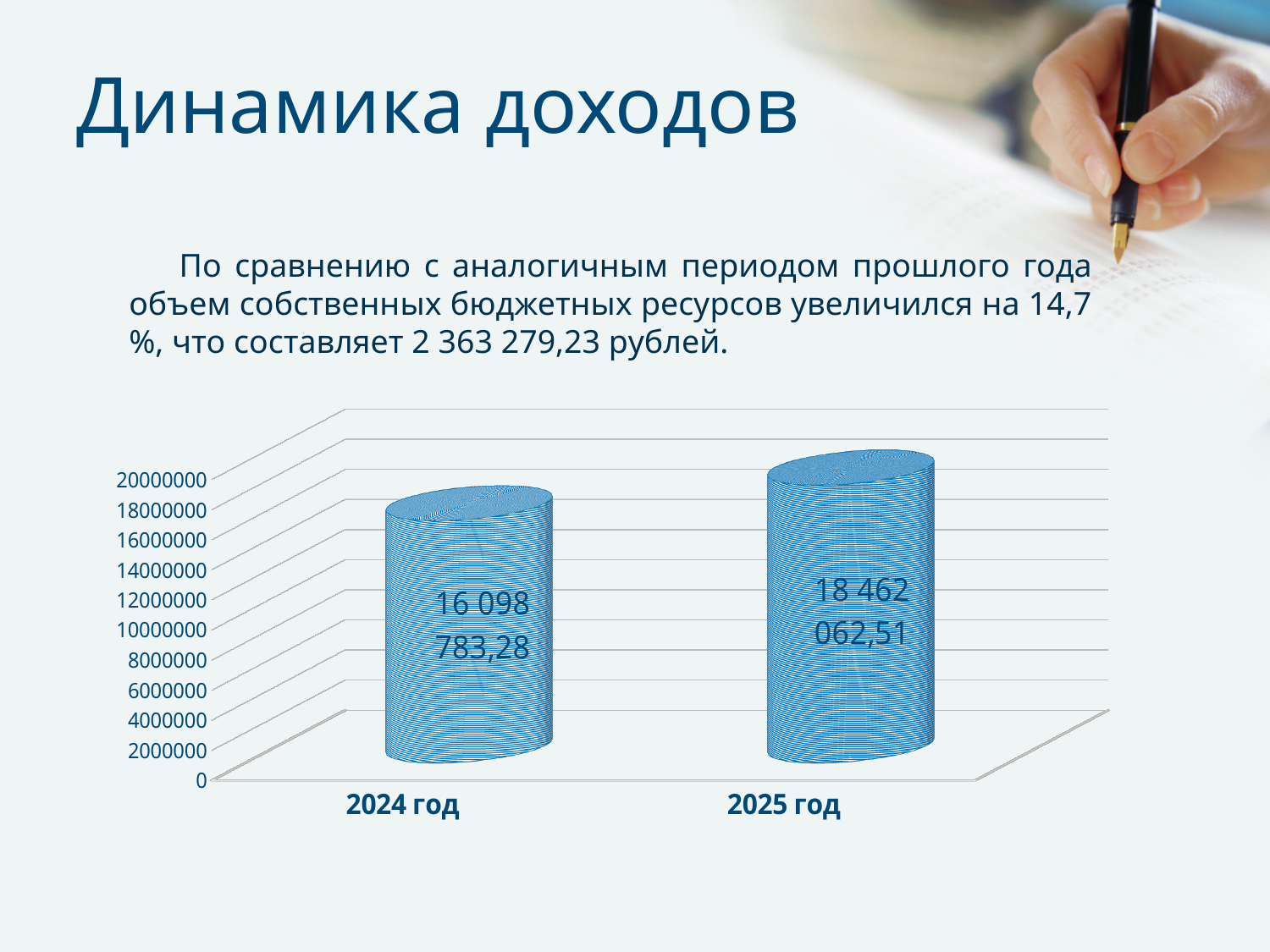
What is the value for 2025 год? 18 462 062,51 What is the difference between the values for 2025 год and 2024 год? 2 363 279,23 What kind of chart is shown on the slide? bar chart How many categories are shown on the chart? 2 What is the value for 2024 год? 16 098 783,28 What is the title of the slide containing the chart? Динамика доходов Do the values rise or fall from 2024 год to 2025 год? rise Is the value for 2025 год greater or less than 18000000? greater Which year has the lowest value? 2024 год Is the value for 2024 год greater or less than 18000000? less Which year has the highest value? 2025 год Which is larger, the value for 2024 год or 2025 год? 2025 год